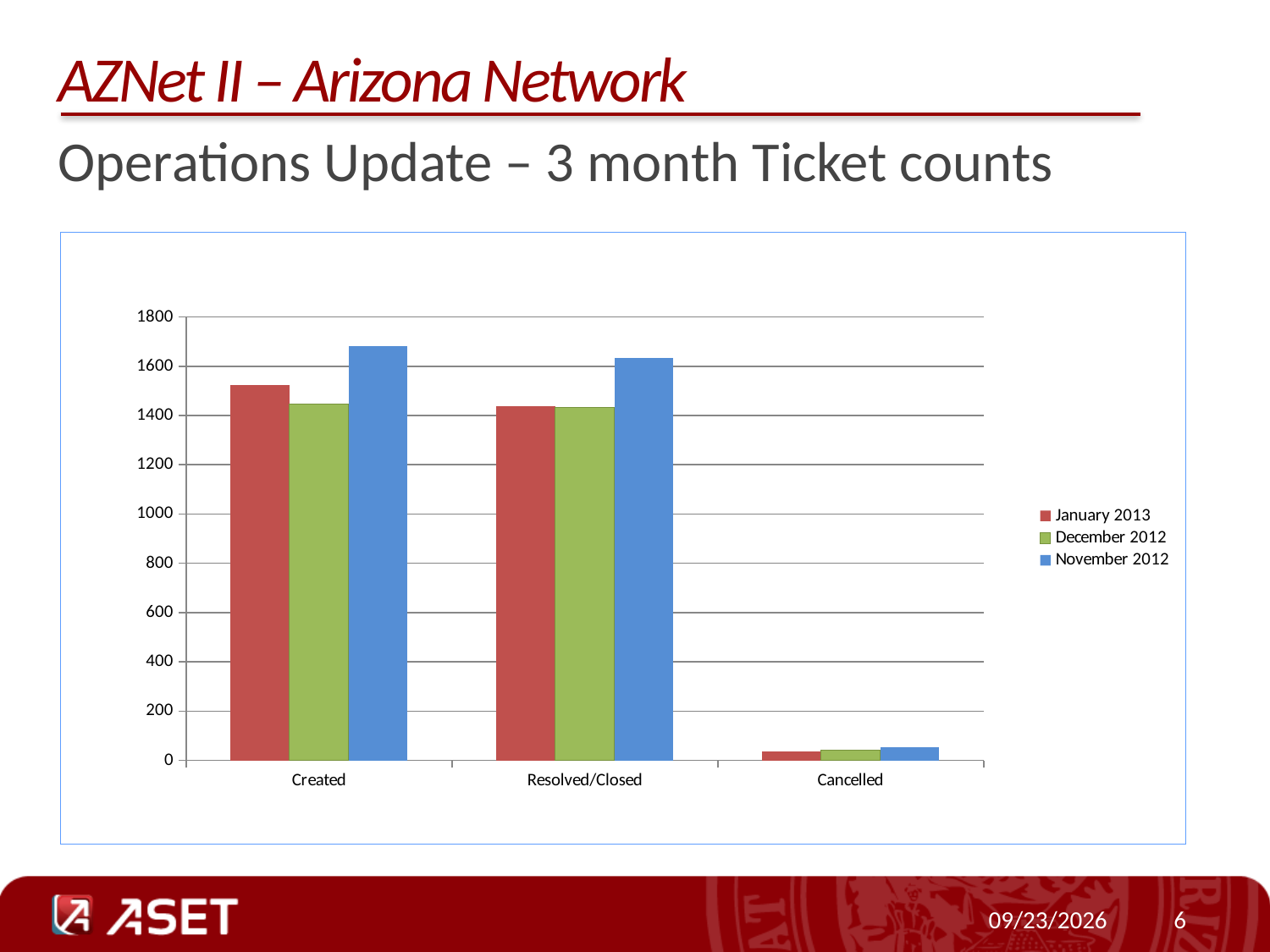
Is the value for January 2013 in the Created category greater or less than 1400? greater In the Created category, which is larger: January 2013 or December 2012? January 2013 In the Resolved/Closed category, which is larger: November 2012 or January 2013? November 2012 Is the value for November 2012 in the Created category greater or less than 1600? greater How many categories are shown on the x axis of the chart? 3 Which category has the lowest values across all three series? Cancelled Is the value for December 2012 in the Created category greater or less than 1600? less Which series has the highest value in the Created category? November 2012 How many series does the chart's legend list? 3 What kind of chart is shown on the slide? bar chart Which series is shown in blue in the chart's legend? November 2012